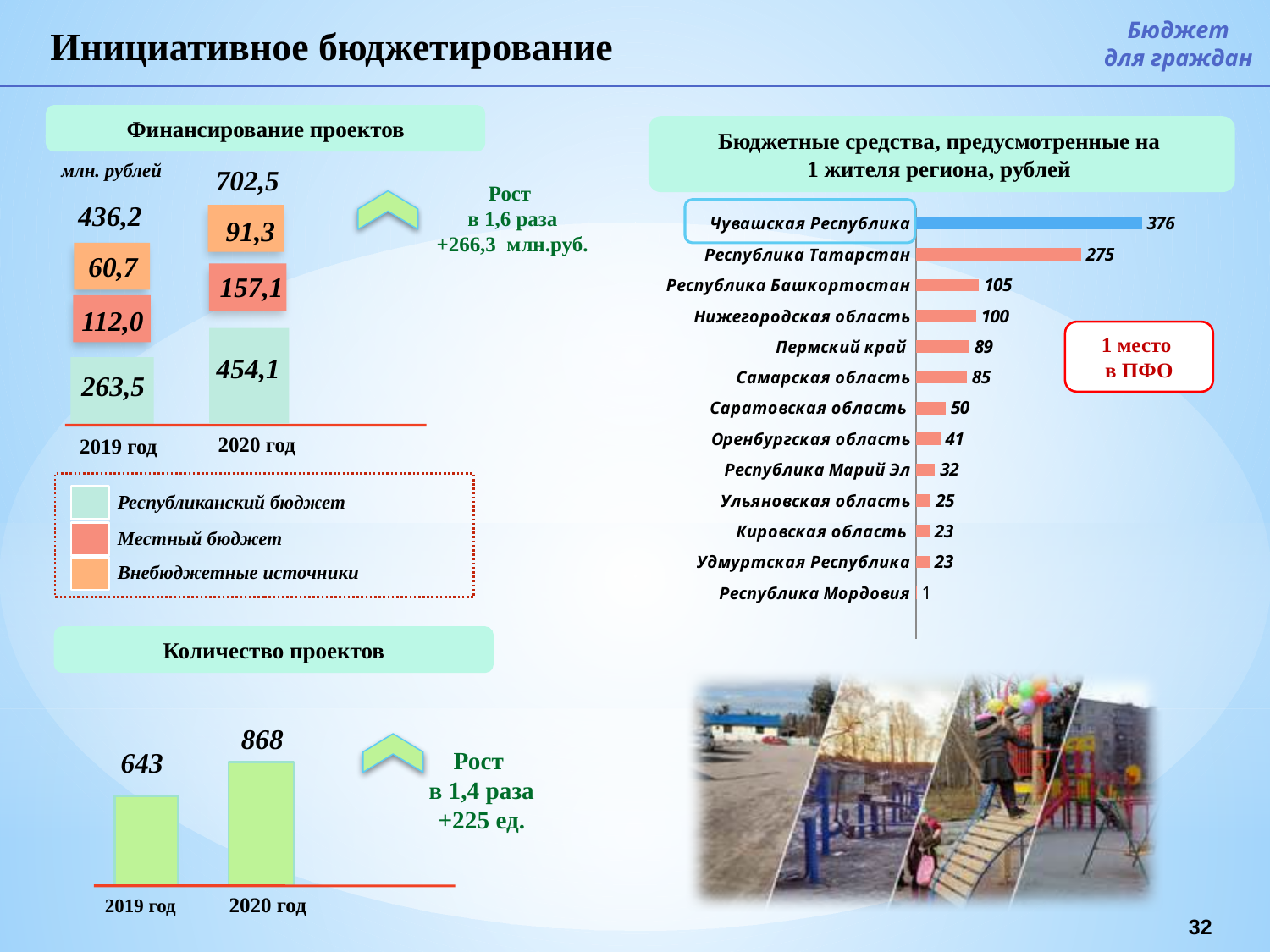
In the chart 'Количество проектов', do the values rise or fall from 2019 год to 2020 год? rise In the chart 'Бюджетные средства, предусмотренные на 1 жителя региона, рублей', what is the difference between Чувашская Республика and Республика Татарстан? 101 In the chart 'Количество проектов', what is the difference between 2020 год and 2019 год? 225 What kind of chart is 'Бюджетные средства, предусмотренные на 1 жителя региона, рублей'? bar chart In the chart 'Бюджетные средства, предусмотренные на 1 жителя региона, рублей', how many regions are shown? 13 In the chart 'Бюджетные средства, предусмотренные на 1 жителя региона, рублей', what is the value for Республика Татарстан? 275 In the chart 'Бюджетные средства, предусмотренные на 1 жителя региона, рублей', which region has the lowest value? Республика Мордовия In the chart 'Бюджетные средства, предусмотренные на 1 жителя региона, рублей', which region has the highest value? Чувашская Республика In the chart 'Бюджетные средства, предусмотренные на 1 жителя региона, рублей', which is larger: Пермский край or Самарская область? Пермский край In the chart 'Финансирование проектов', what is the total of the stacked bar for 2019 год? 436,2 In the chart 'Финансирование проектов', what is the value of Республиканский бюджет for 2020 год? 454,1 In the chart 'Финансирование проектов', how many series does the legend list? 3